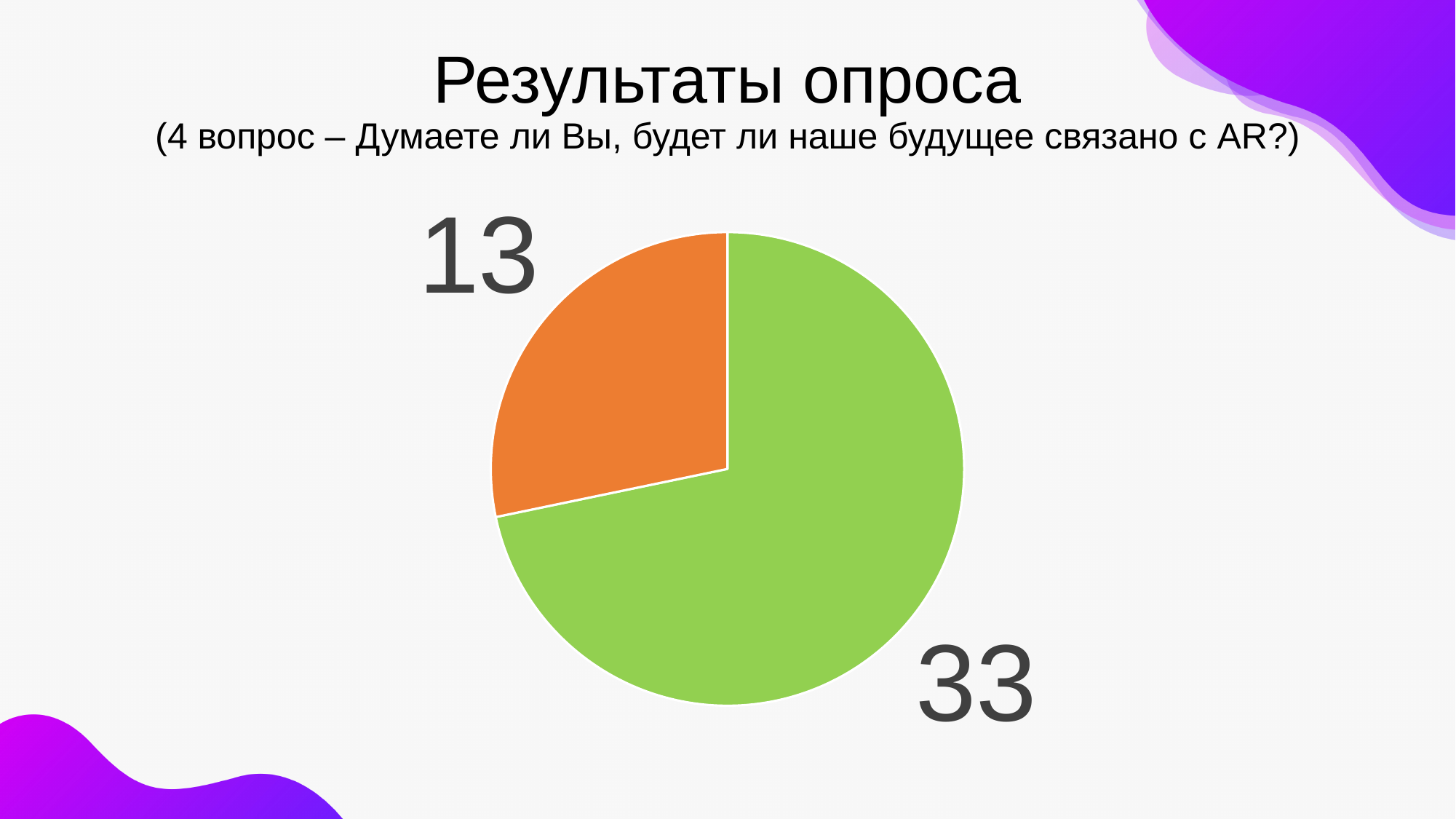
What value is shown for the orange slice of the pie chart? 13 What value is shown for the green slice of the pie chart? 33 What is the total of the two values shown on the pie chart? 46 What kind of chart is shown on the slide? pie chart What is the difference between the green slice value and the orange slice value? 20 How many slices does the pie chart have? 2 Which survey question does the pie chart refer to, according to the subtitle? 4 вопрос – Думаете ли Вы, будет ли наше будущее связано с AR? Which slice of the pie chart is the largest? the green slice (33) Is the green slice or the orange slice larger? the green slice Which slice of the pie chart is the smallest? the orange slice (13) What is the title of the slide containing the pie chart? Результаты опроса